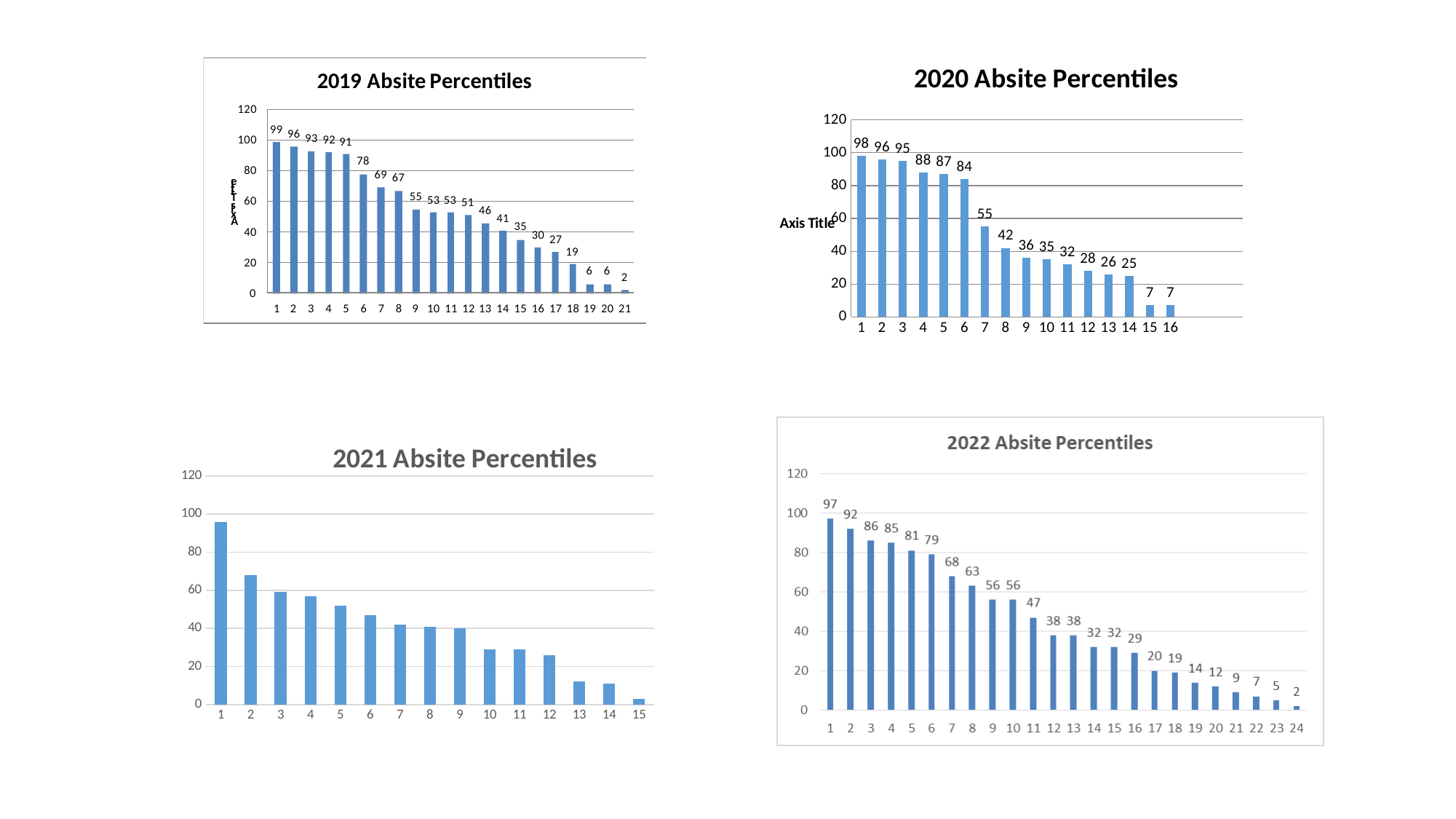
In the 2020 Absite Percentiles chart, which category has the highest value? 1 In the 2021 Absite Percentiles chart, how many bars are plotted? 15 In the 2021 Absite Percentiles chart, do the values rise or fall from left to right along the x axis? fall What kind of chart is the 2022 Absite Percentiles chart? bar chart In the 2022 Absite Percentiles chart, what is the value for category 11? 47 In the 2019 Absite Percentiles chart, how many bars are plotted? 21 In the 2020 Absite Percentiles chart, how many bars are plotted? 16 In the 2021 Absite Percentiles chart, is the value for category 2 greater or less than 60? greater In the 2019 Absite Percentiles chart, what is the difference between the values for category 1 and category 21? 97 In the 2020 Absite Percentiles chart, what is the value for category 7? 55 In the 2022 Absite Percentiles chart, which is larger, the value for category 7 or category 8? category 7 In the 2019 Absite Percentiles chart, what is the value for category 6? 78